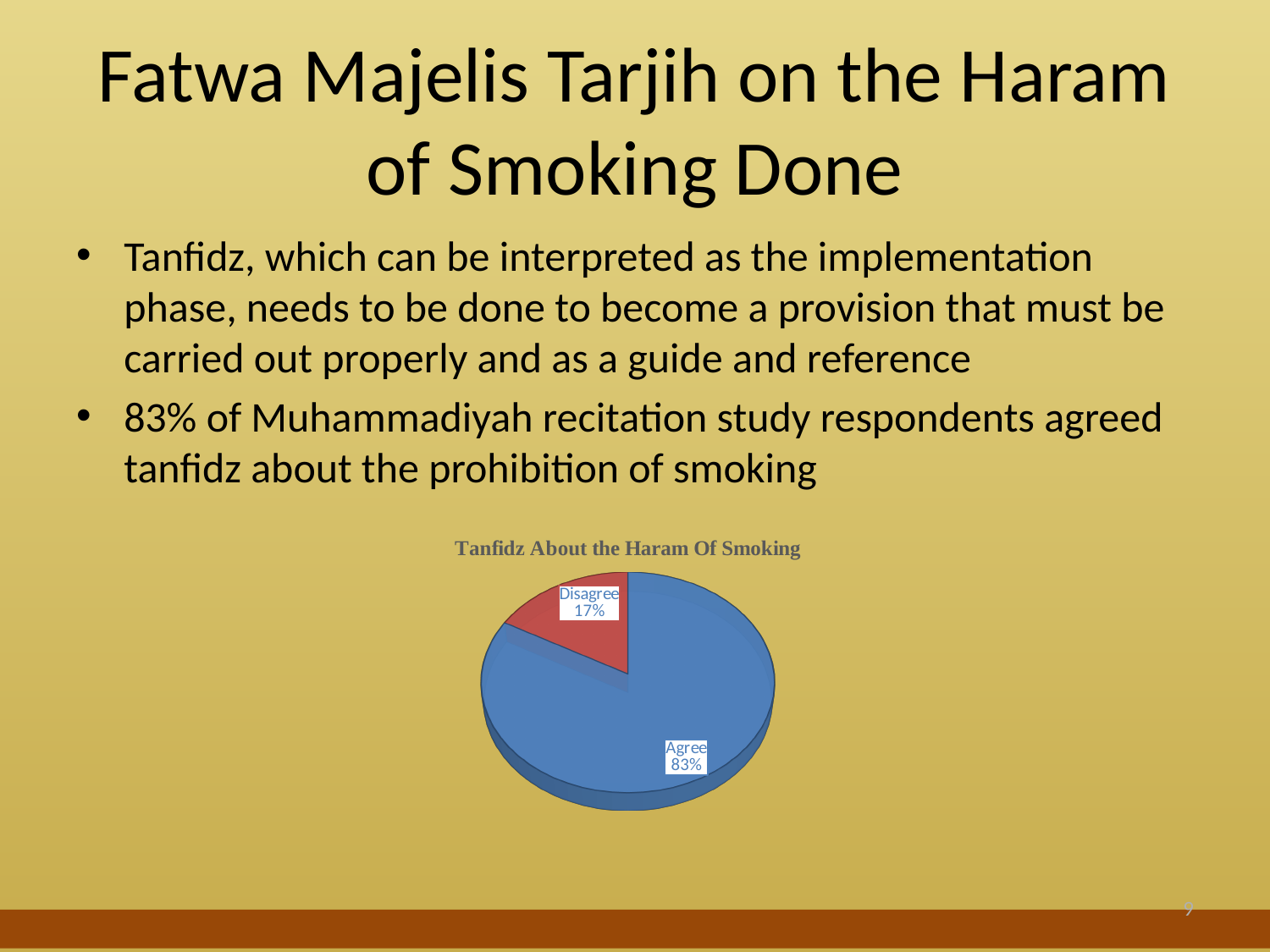
What is the chart's title? Tanfidz About the Haram Of Smoking What kind of chart is shown on the slide? pie chart What is the difference in percentage points between the Agree and Disagree slices? 66 Which slice of the pie is the smallest? Disagree How many slices does the pie chart have? 2 What colour is the Disagree slice? red What share of the pie is labelled Agree? 83% Which is larger, the Agree slice or the Disagree slice? Agree Which slice of the pie is the largest? Agree What share of the pie is labelled Disagree? 17%